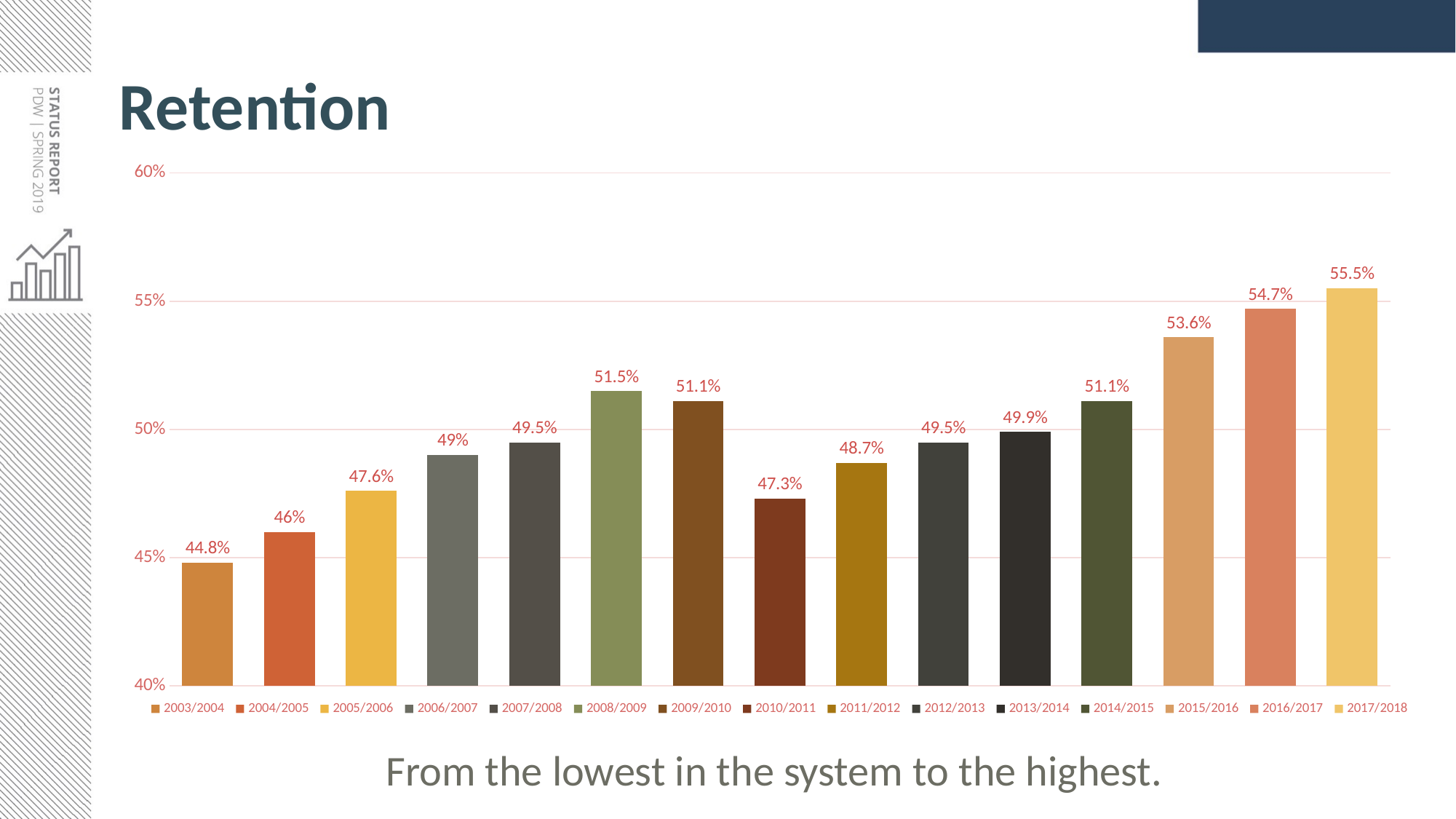
Which is larger, the retention value for 2008/2009 or for 2011/2012? 2008/2009 Which year has the highest retention value? 2017/2018 What is the retention value for 2010/2011? 47.3% What is the retention value for 2003/2004? 44.8% What kind of chart is shown on the slide? bar chart How many years are shown on the chart? 15 What is the retention value for 2015/2016? 53.6% Is the retention value for 2006/2007 greater or less than 50%? less What is the difference between the retention values for 2017/2018 and 2003/2004? 10.7% Do the retention values overall rise or fall from 2003/2004 to 2017/2018? rise Which year has the lowest retention value? 2003/2004 What is the difference between the retention values for 2008/2009 and 2010/2011? 4.2%